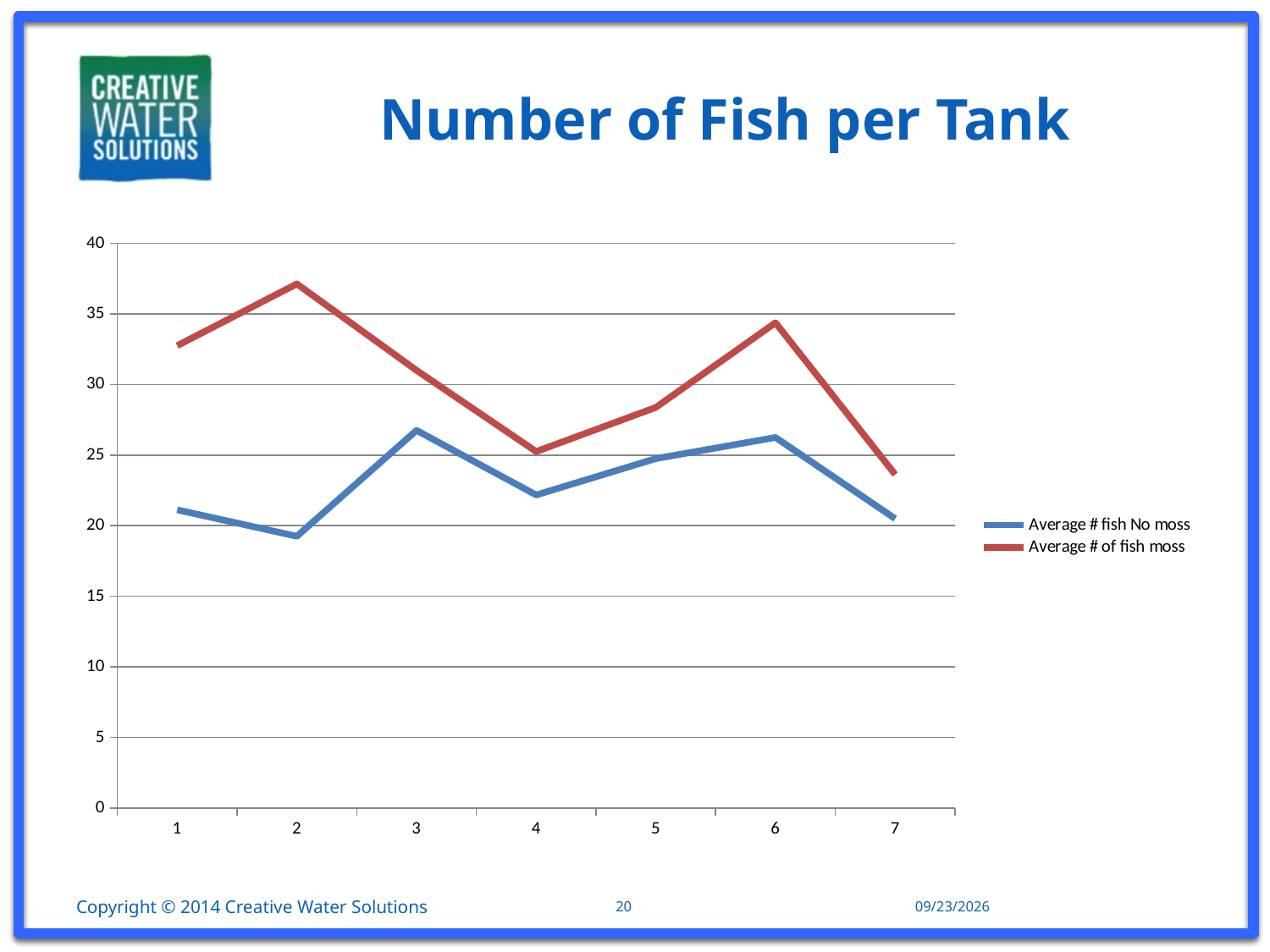
At which x-axis point is the value for Average # fish No moss lowest? 2 Does the value for Average # of fish moss rise or fall from point 6 to point 7? fall What is the title of the chart? Number of Fish per Tank How many points are plotted along the x axis for each series? 7 At which x-axis point is the value for Average # of fish moss highest? 2 Is the value for Average # fish No moss at point 2 greater or less than 20? less At which x-axis point is the value for Average # of fish moss lowest? 7 What kind of chart is shown on the slide? line chart How many series does the legend list? 2 At point 4, which series has the larger value, Average # fish No moss or Average # of fish moss? Average # of fish moss Is the value for Average # of fish moss at point 1 greater or less than 30? greater Is the value for Average # of fish moss at point 2 greater or less than 35? greater